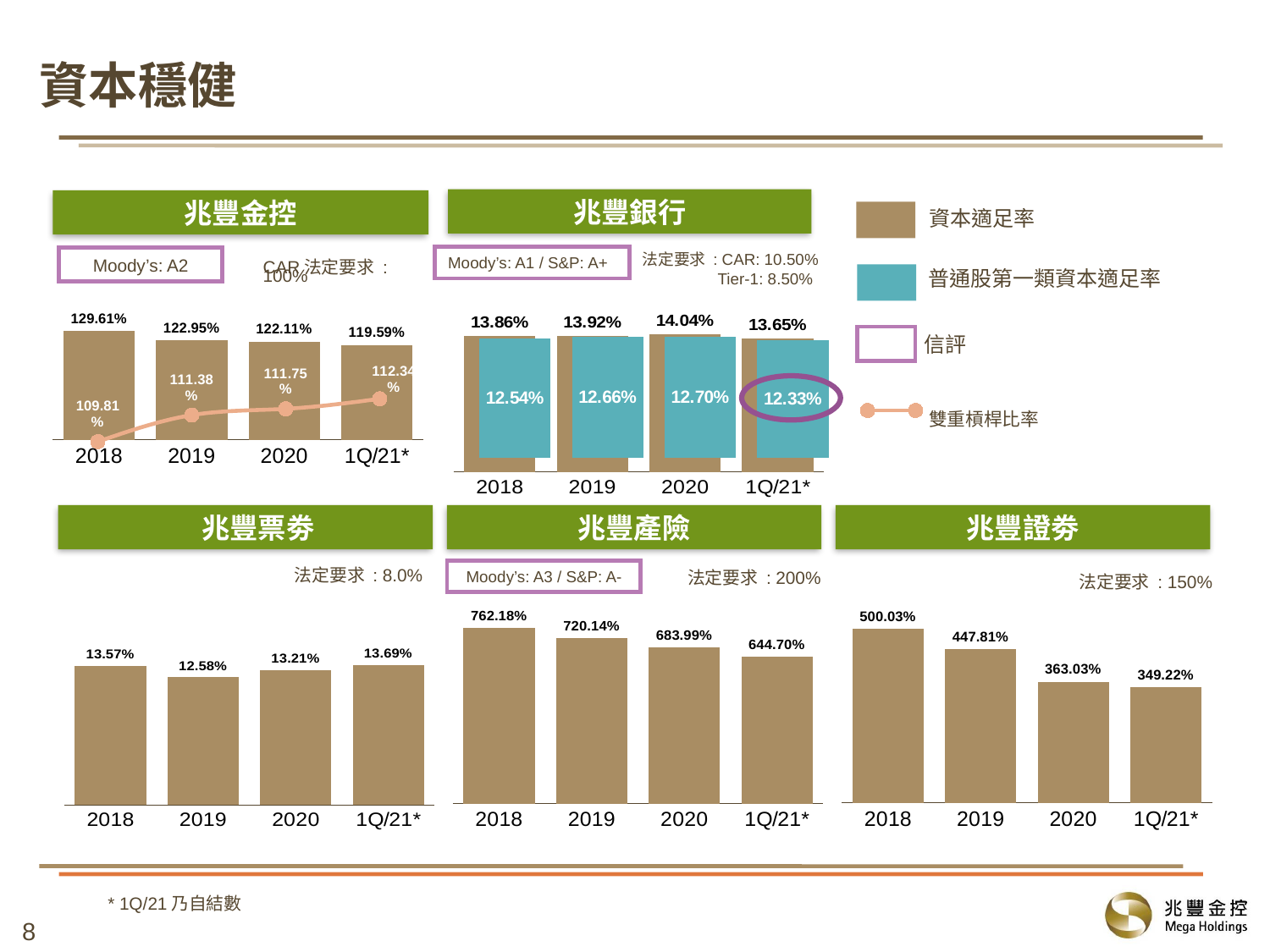
In the 兆豐票券 chart, which period has the lowest value? 2019 In the 兆豐票券 chart, what is the value for 1Q/21*? 13.69% In the 兆豐金控 chart, what is the 資本適足率 value for 2018? 129.61% In the 兆豐產險 chart, what is the difference between the 2018 and 2019 values? 42.04% In the 兆豐銀行 chart, which year has the highest 資本適足率? 2020 In the 兆豐產險 chart, do the values rise or fall from 2018 to 1Q/21*? fall In the 兆豐銀行 chart, what is the 普通股第一類資本適足率 value for 2020? 12.70% In the 兆豐銀行 chart, what is the difference between the 資本適足率 and the 普通股第一類資本適足率 for 1Q/21*? 1.32% What kind of chart is the 兆豐票券 chart? bar chart How many periods are shown on the x axis of the 兆豐證券 chart? 4 In the 兆豐證券 chart, which is larger, the value for 2020 or the value for 1Q/21*? 2020 In the 兆豐金控 chart, what is the 雙重槓桿比率 value for 1Q/21*? 112.34%